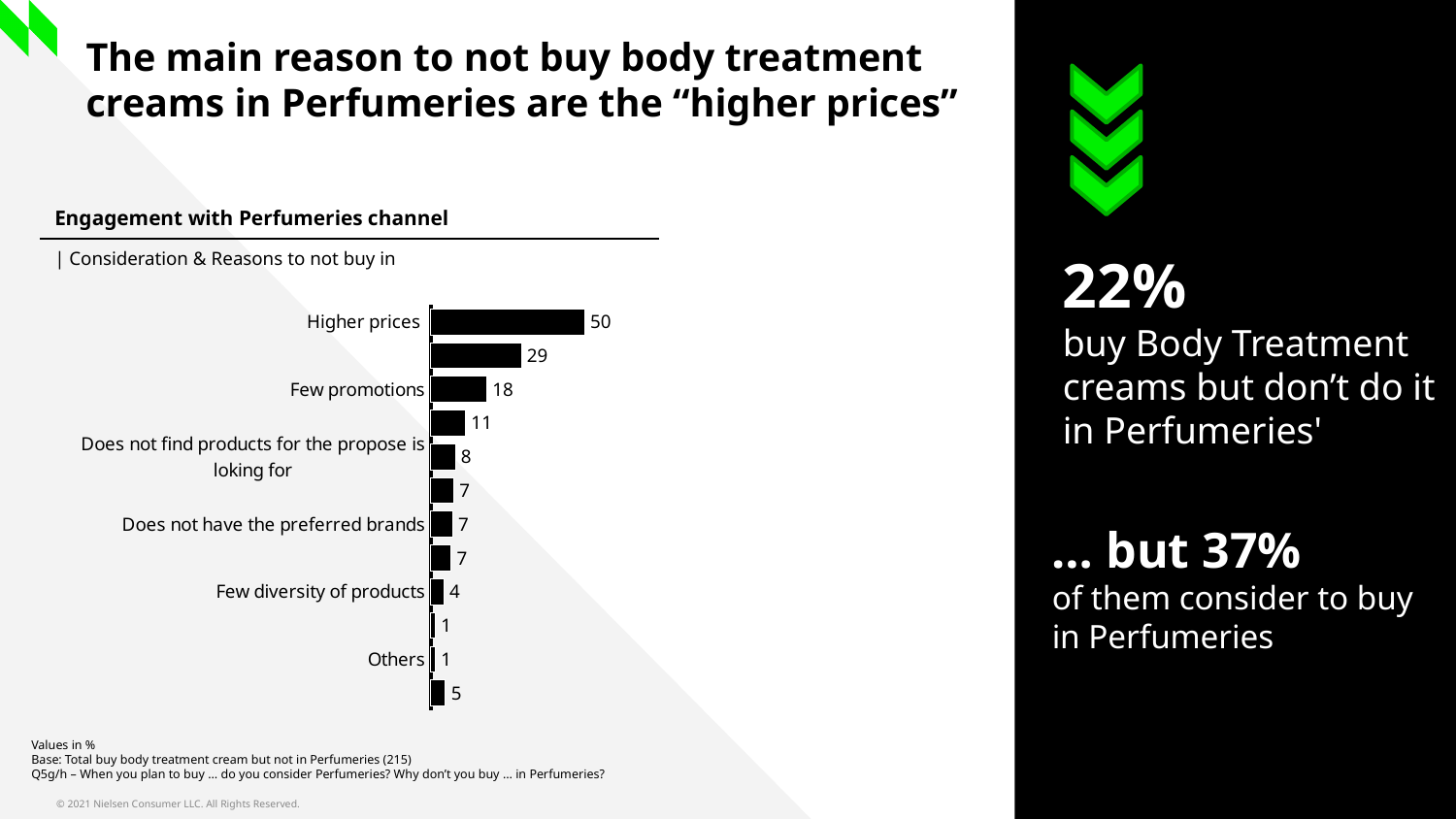
What is the value for Does not have the preferred brands? 7 What is the value for Does not find products for the propose is loking for? 8 What is the value for Higher prices? 50 Which reason has the highest value? Higher prices What kind of chart is shown? Bar chart How many bars are plotted in the chart? 12 Which is larger, the value for Few promotions or the value for Few diversity of products? Few promotions What is the title of the chart section? Engagement with Perfumeries channel What is the value for Few promotions? 18 What is the value for Few diversity of products? 4 What is the value for Others? 1 What is the difference between the values for Higher prices and Few promotions? 32